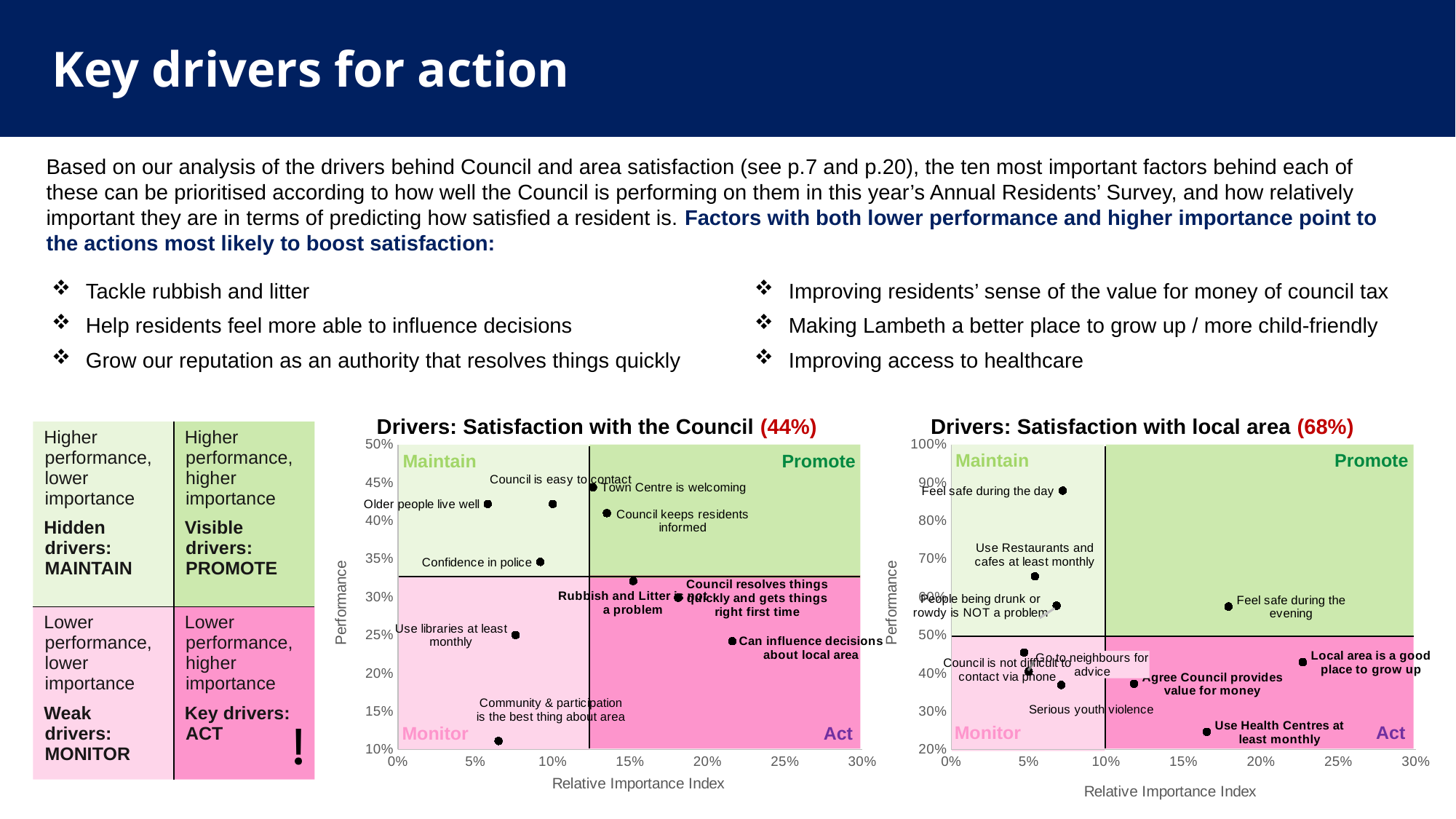
In the 'Drivers: Satisfaction with local area' chart, which point has the highest performance? Feel safe during the day What percentage is shown in the title of the 'Drivers: Satisfaction with local area' chart? 68% In the 'Drivers: Satisfaction with the Council' chart, which point has the lowest performance? Community & participation is the best thing about area In the 'Drivers: Satisfaction with local area' chart, which point has the lowest performance? Use Health Centres at least monthly What kind of chart is 'Drivers: Satisfaction with the Council'? Scatter chart What is the x-axis title of the 'Drivers: Satisfaction with the Council' chart? Relative Importance Index In the 'Drivers: Satisfaction with the Council' chart, is the relative importance index for 'Use libraries at least monthly' greater or less than 10%? less In the 'Drivers: Satisfaction with local area' chart, is the performance for 'Feel safe during the day' greater or less than 80%? greater In the 'Drivers: Satisfaction with local area' chart, which has higher performance: 'Feel safe during the evening' or 'Serious youth violence'? Feel safe during the evening In the 'Drivers: Satisfaction with the Council' chart, is the performance for 'Confidence in police' greater or less than 40%? less In the 'Drivers: Satisfaction with the Council' chart, which has higher performance: 'Council is easy to contact' or 'Community & participation is the best thing about area'? Council is easy to contact